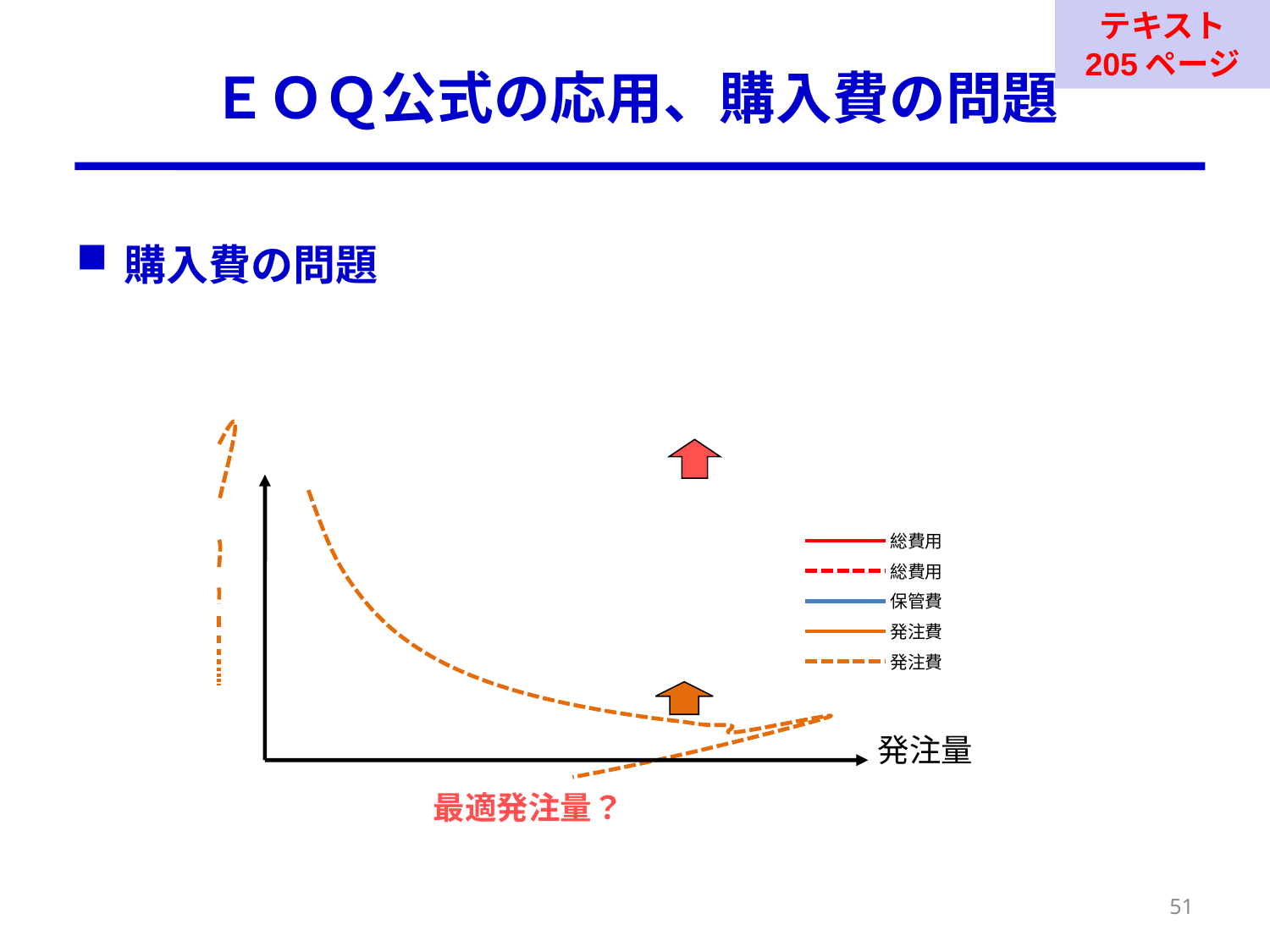
What is the label on the chart's x axis? 発注量 Which legend entry is drawn with a blue line? 保管費 Does the dashed orange 発注費 curve rise or fall as 発注量 increases along the x axis? fall What kind of chart is shown on the slide? line chart How many series does the chart's legend list? 5